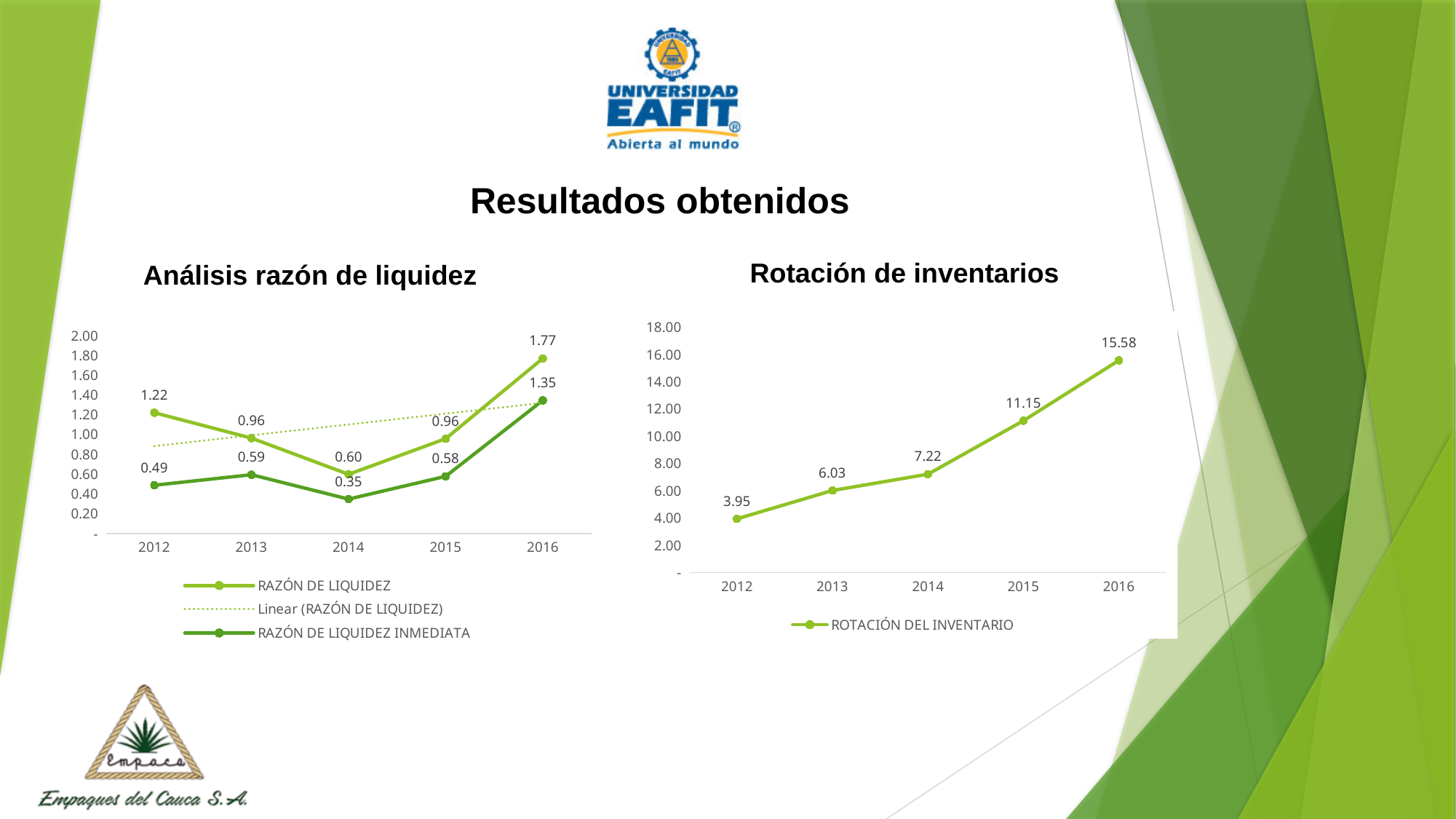
In the 'Análisis razón de liquidez' chart, what is the RAZÓN DE LIQUIDEZ value for 2014? 0.60 In the 'Análisis razón de liquidez' chart, which year has the lowest RAZÓN DE LIQUIDEZ INMEDIATA value? 2014 In the 'Análisis razón de liquidez' chart, which year has the highest RAZÓN DE LIQUIDEZ value? 2016 In the 'Rotación de inventarios' chart, what is the value for 2016? 15.58 In the 'Rotación de inventarios' chart, do the values rise or fall from 2012 to 2016? rise In the 'Rotación de inventarios' chart, what is the value for 2012? 3.95 In the 'Análisis razón de liquidez' chart, how many entries does the legend list? 3 In the 'Rotación de inventarios' chart, what is the difference between the 2015 and 2014 values? 3.93 In the 'Análisis razón de liquidez' chart, what is the difference between the RAZÓN DE LIQUIDEZ and RAZÓN DE LIQUIDEZ INMEDIATA values in 2012? 0.73 In the 'Análisis razón de liquidez' chart, what is the RAZÓN DE LIQUIDEZ INMEDIATA value for 2016? 1.35 In the 'Rotación de inventarios' chart, which year has the lowest value? 2012 What kind of chart is the 'Rotación de inventarios' chart? line chart